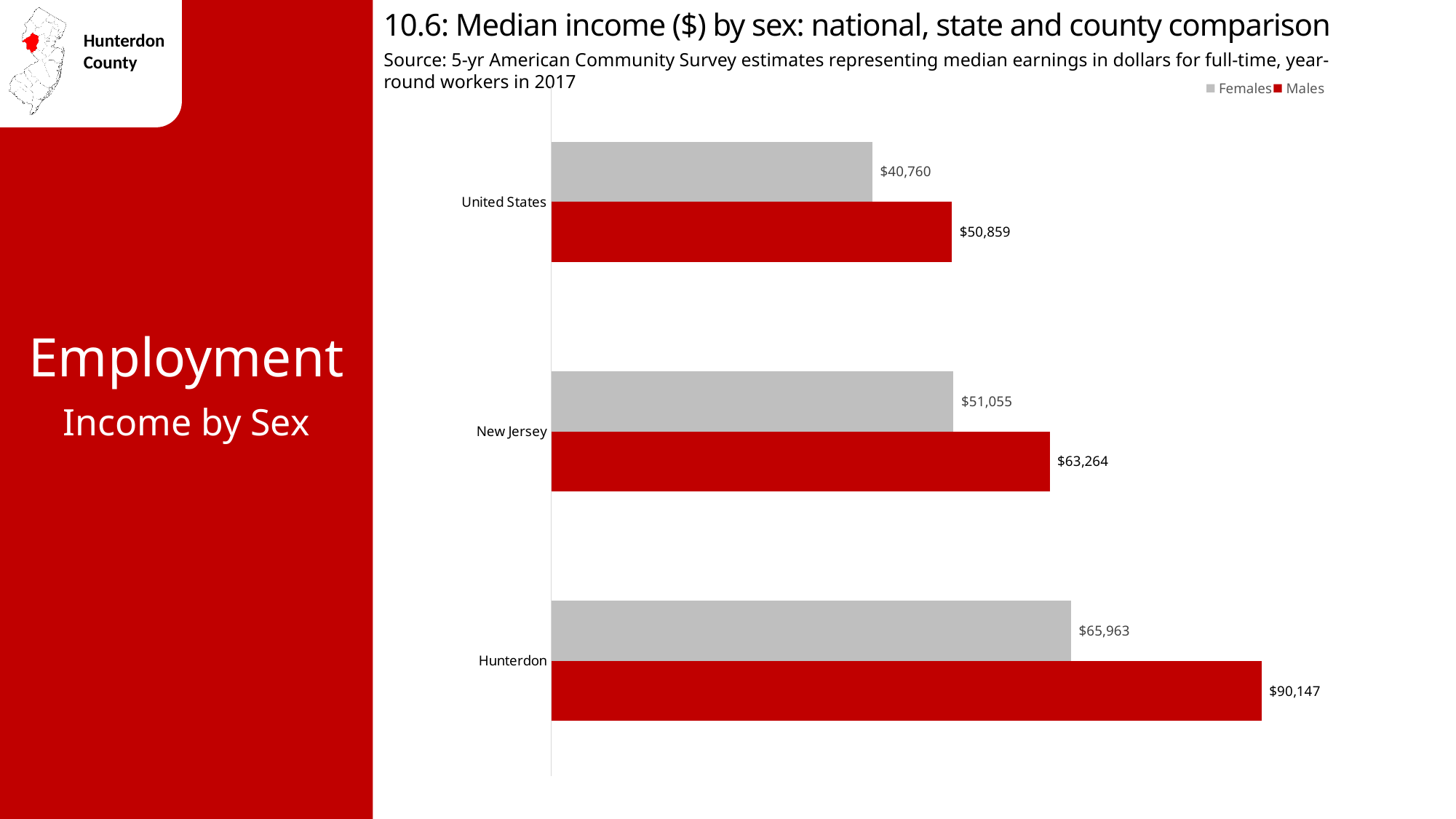
What is the median income for females in the United States? $40,760 What is the difference between male and female median income in New Jersey? $12,209 Which is larger: the median income for females in Hunterdon or for males in New Jersey? Females in Hunterdon What is the median income for males in Hunterdon? $90,147 How many series does the legend list? 2 Which geography has the highest median income for males? Hunterdon What is the median income for males in the United States? $50,859 What type of chart is shown on the slide? Bar chart Which geography has the lowest median income for females? United States How many geographies are compared in the chart? 3 What is the difference between male and female median income in Hunterdon? $24,184 What is the median income for females in New Jersey? $51,055